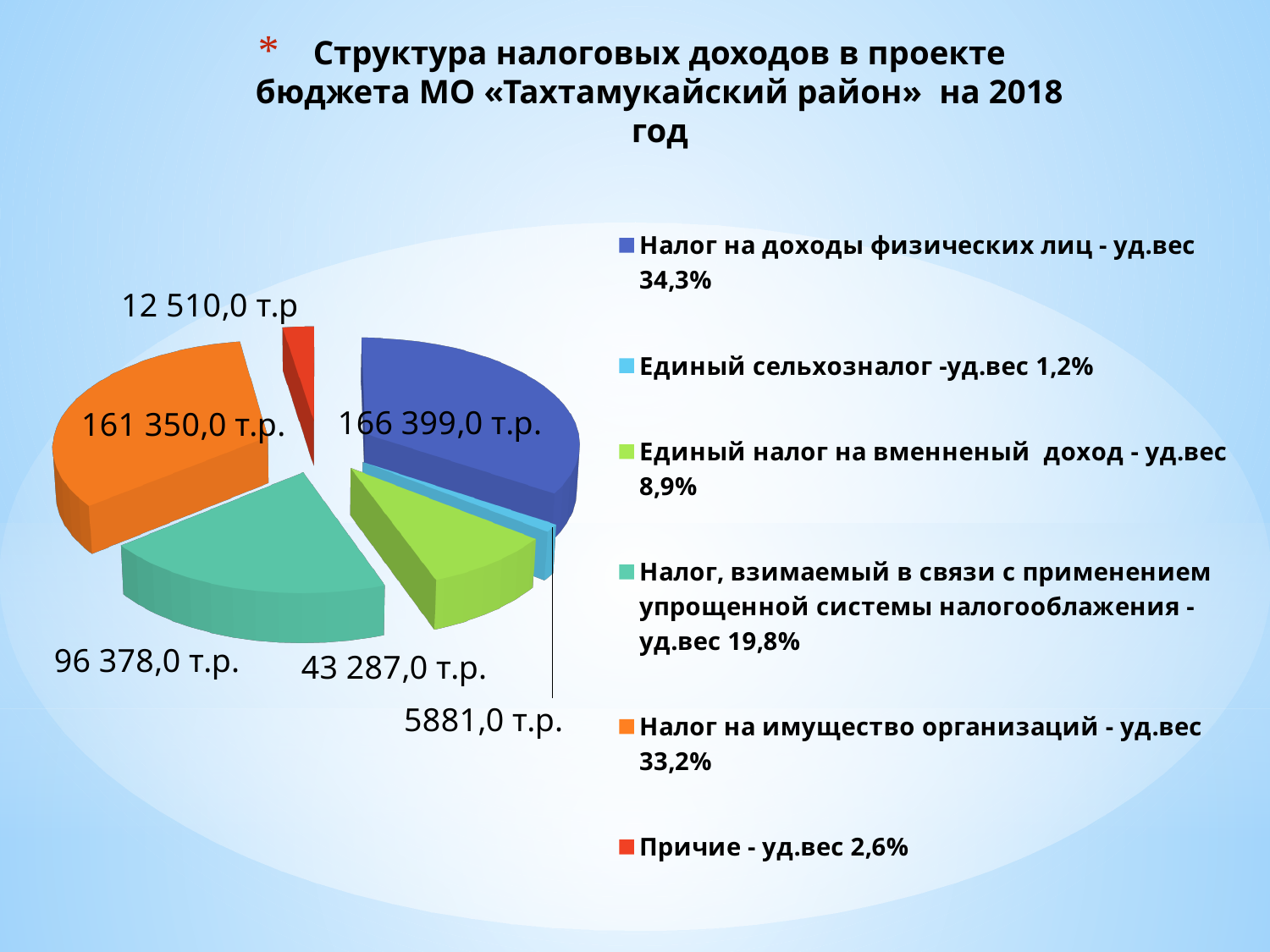
What share of the pie does «Налог, взимаемый в связи с применением упрощенной системы налогооблажения» represent? 19,8% What is the value shown for «Единый сельхозналог»? 5881,0 т.р. What share of the pie does «Налог на имущество организаций» represent, according to the legend? 33,2% What is the value shown for «Единый налог на вменненый доход»? 43 287,0 т.р. What is the value shown for «Налог на имущество организаций»? 161 350,0 т.р. Which is larger: the value for «Налог, взимаемый в связи с применением упрощенной системы налогооблажения» or for «Единый налог на вменненый доход»? Налог, взимаемый в связи с применением упрощенной системы налогооблажения What colour is the slice for «Причие» in the pie chart? Red Which category has the largest value in the pie chart? Налог на доходы физических лиц Which category has the smallest value in the pie chart? Единый сельхозналог How many slices does the pie chart have? 6 What is the value shown for «Налог на доходы физических лиц»? 166 399,0 т.р. What kind of chart is shown on the slide? Pie chart